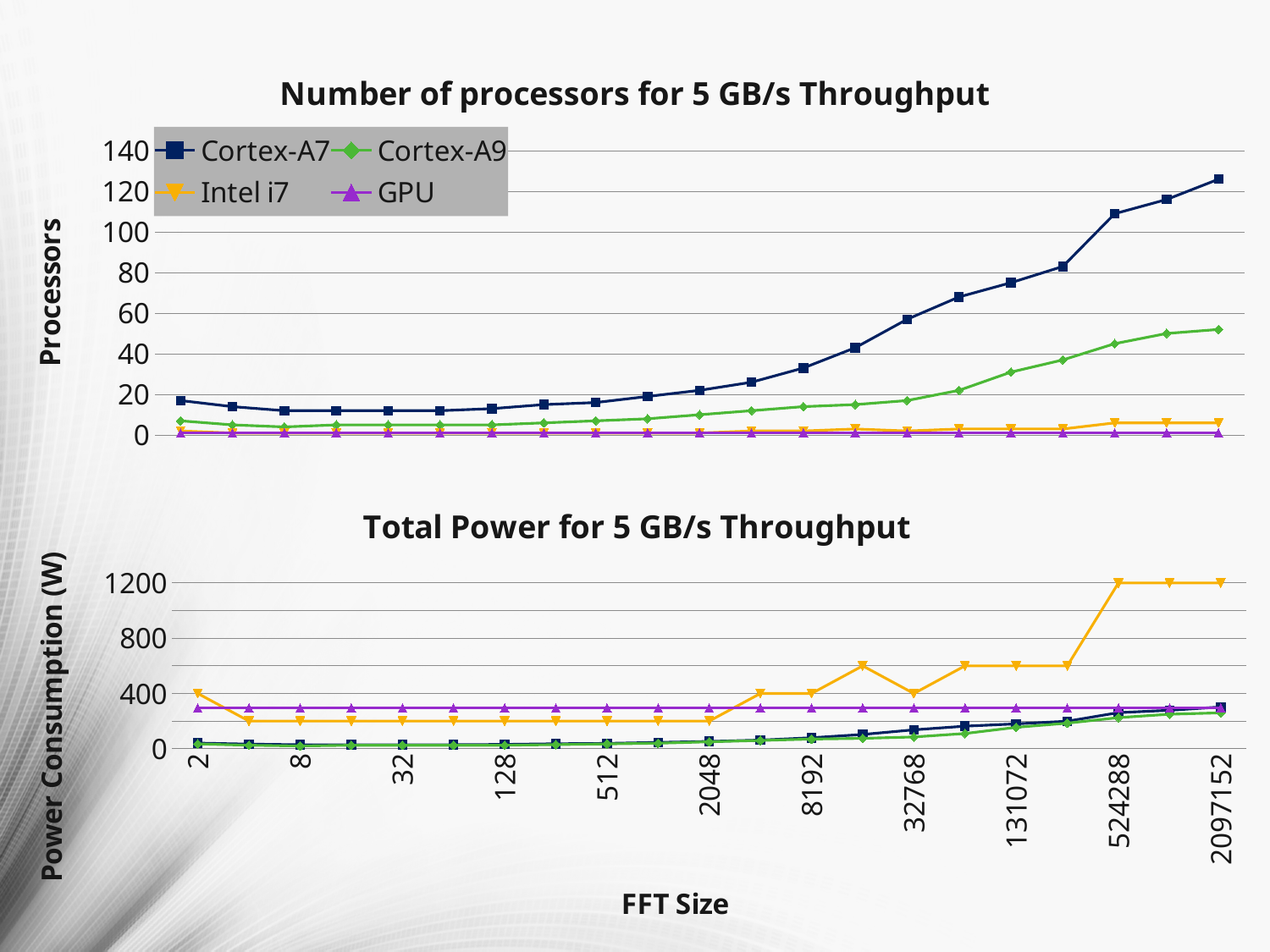
In the bottom chart, 'Total Power for 5 GB/s Throughput', which series has the highest power consumption at FFT size 2097152? Intel i7 In the bottom chart, is the value for Intel i7 at FFT size 2097152 greater or less than 800? greater In the top chart, which series has the lowest number of processors at FFT size 2097152? GPU In the top chart, does the Cortex-A7 series rise or fall as FFT size increases from 2048 to 2097152? rise In the top chart, which is larger at FFT size 131072: Cortex-A7 or Cortex-A9? Cortex-A7 What is the label of the x axis shared by the charts? FFT Size In the top chart, is the value for Cortex-A7 at FFT size 2097152 greater or less than 120? greater In the top chart, which series has the highest number of processors at FFT size 2097152? Cortex-A7 In the top chart, is the value for Cortex-A9 at FFT size 2097152 greater or less than 40? greater What kind of chart is the top chart, 'Number of processors for 5 GB/s Throughput'? line chart How many series does the legend of the top chart list? 4